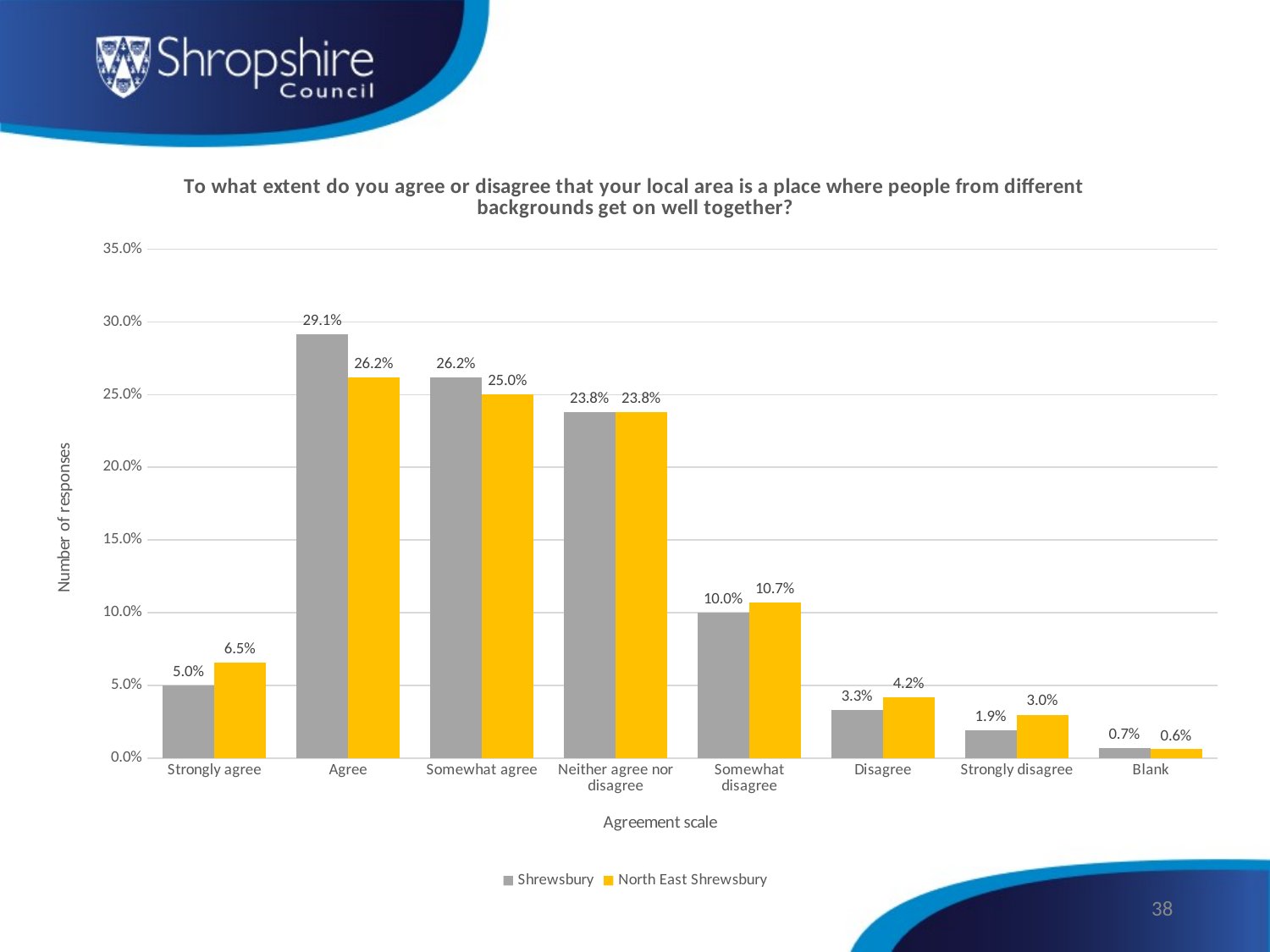
Is the value for Shrewsbury in the Somewhat agree category greater or less than 25.0%? greater What is the value for Shrewsbury in the Agree category? 29.1% What kind of chart is shown on the slide? Bar chart What is the label of the x axis? Agreement scale What is the value for North East Shrewsbury in the Somewhat disagree category? 10.7% What is the value for North East Shrewsbury in the Strongly agree category? 6.5% What is the difference between the Shrewsbury and North East Shrewsbury values in the Agree category? 2.9% Which category has the highest value for Shrewsbury? Agree How many series does the legend list? 2 Which category has the lowest value for North East Shrewsbury? Blank How many categories are shown on the x axis? 8 Which is larger in the Disagree category: Shrewsbury or North East Shrewsbury? North East Shrewsbury